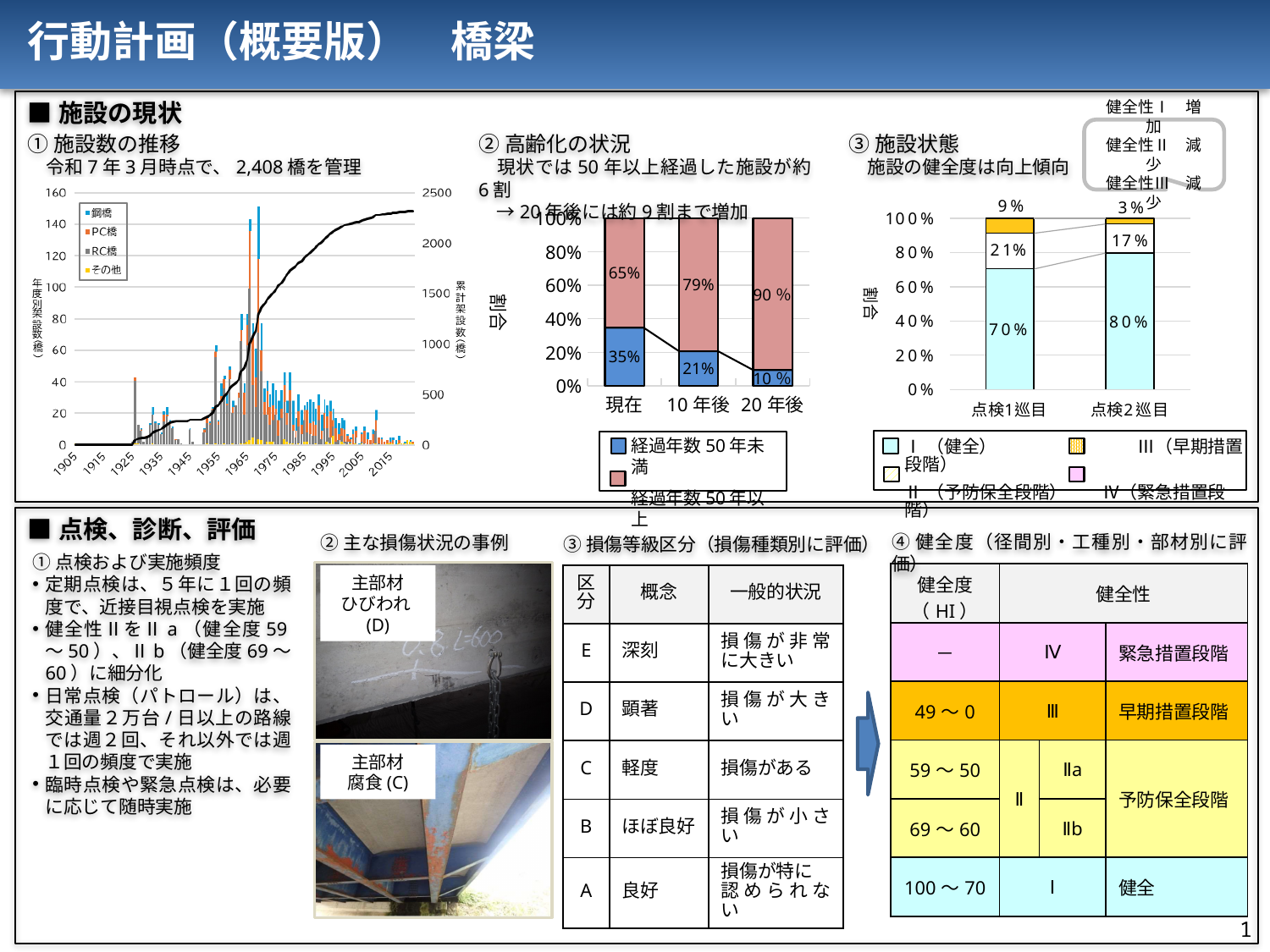
In the chart titled 施設状態, how many series does the legend list? 4 In the chart titled 施設状態, which is larger: the II (予防保全段階) value at 点検1巡目 or at 点検2巡目? 点検1巡目 In the chart titled 高齢化の状況, what is the value for 経過年数50年以上 at 現在? 65% In the chart titled 施設状態, what is the value for III (早期措置段階) at 点検1巡目? 9% In the chart titled 施設数の推移, how many series does the legend list? 4 In the chart titled 高齢化の状況, what is the difference between the 経過年数50年以上 values at 20年後 and 現在? 25% In the chart titled 高齢化の状況, what is the value for 経過年数50年未満 at 20年後? 10% In the chart titled 施設状態, what is the value for I (健全) at 点検2巡目? 80% In the chart titled 高齢化の状況, how many categories are shown on the x axis? 3 In the chart titled 高齢化の状況, does the value for 経過年数50年未満 rise or fall from 現在 to 20年後? fall In the chart titled 高齢化の状況, which category has the highest value for 経過年数50年以上? 20年後 In the chart titled 施設状態, what is the difference between the I (健全) values at 点検2巡目 and 点検1巡目? 10%